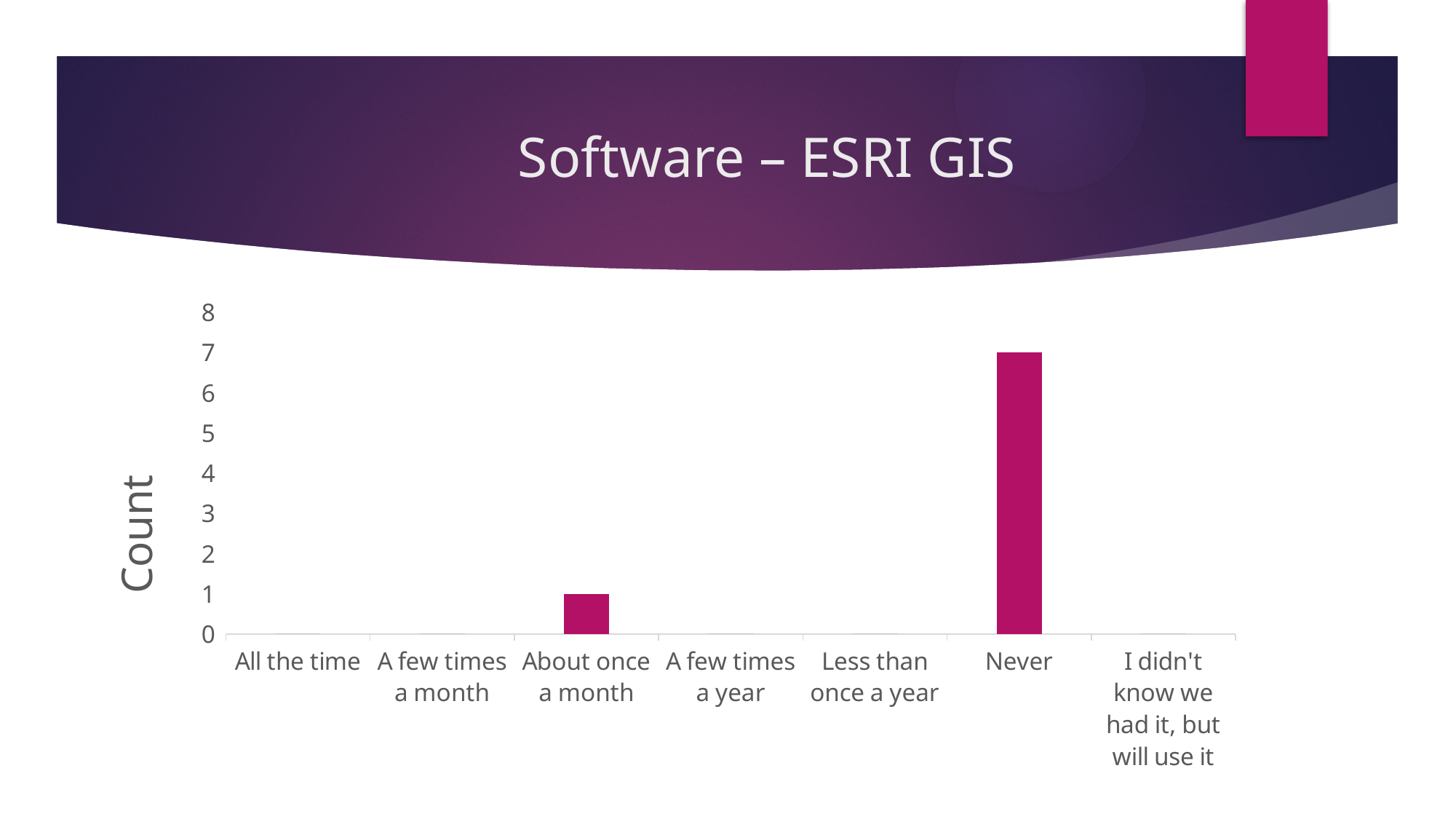
Is the count for "Never" greater or less than 5? greater What is the title of the slide? Software – ESRI GIS How many categories are shown on the x axis? 7 What kind of chart is shown on the slide? bar chart What is the count for the "Never" category? 7 What is the difference between the counts for "Never" and "About once a month"? 6 What is the count for the "About once a month" category? 1 What is the count for the "All the time" category? 0 How many categories have a count of 0? 5 Which category has the highest count? Never What is the label of the vertical axis? Count Which is larger, the count for "Never" or the count for "About once a month"? Never